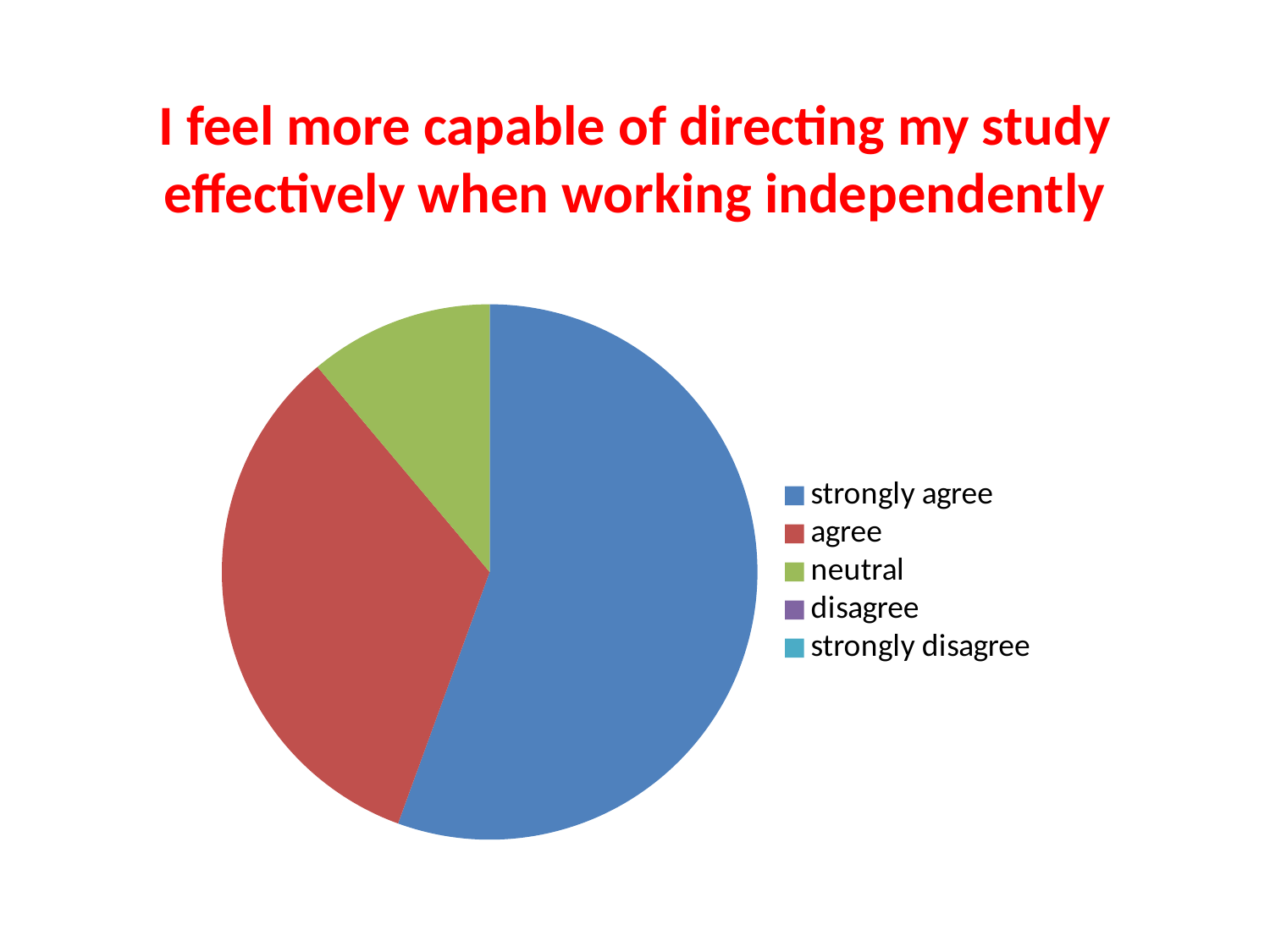
What colour is the strongly agree slice? blue How many entries does the legend list? 5 Does the strongly agree slice take up more or less than half of the pie? more How many slices are visible in the pie? 3 Which slice is larger, strongly agree or agree? strongly agree Which of the visible slices is the smallest? neutral What kind of chart is shown on the slide? pie chart What is the title of the chart? I feel more capable of directing my study effectively when working independently Which response category has the largest slice of the pie? strongly agree Which slice is larger, agree or neutral? agree